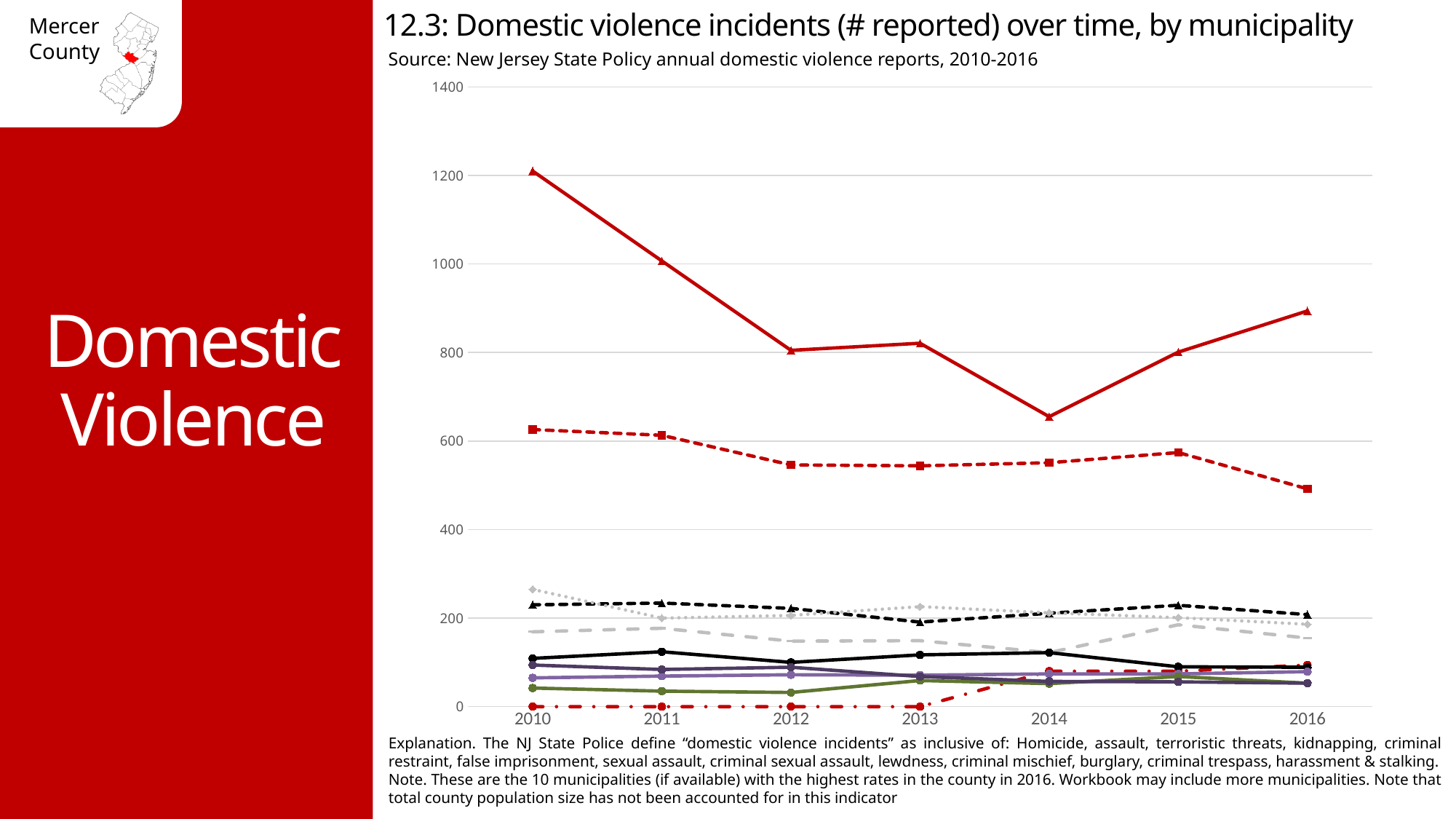
Does the solid red line with triangle markers (the highest line) rise or fall between 2010 and 2014? fall What is the highest value labelled on the y axis of the chart? 1400 What kind of chart is shown on the slide? line chart Is the 2010 value of the dashed red line with square markers greater or less than 600? greater Is the 2010 value of the solid red line with triangle markers (the highest line) greater or less than 1000? greater What is the first year shown on the x axis of the chart? 2010 Does the solid red line with triangle markers rise or fall between 2014 and 2016? rise How many years are shown along the x axis of the chart? 7 In which year does the solid red line with triangle markers (the highest line) reach its lowest point? 2014 Is the 2016 value of the dashed red line with square markers greater or less than 600? less In 2016, which is larger: the solid red line with triangle markers or the dashed red line with square markers? the solid red line with triangle markers